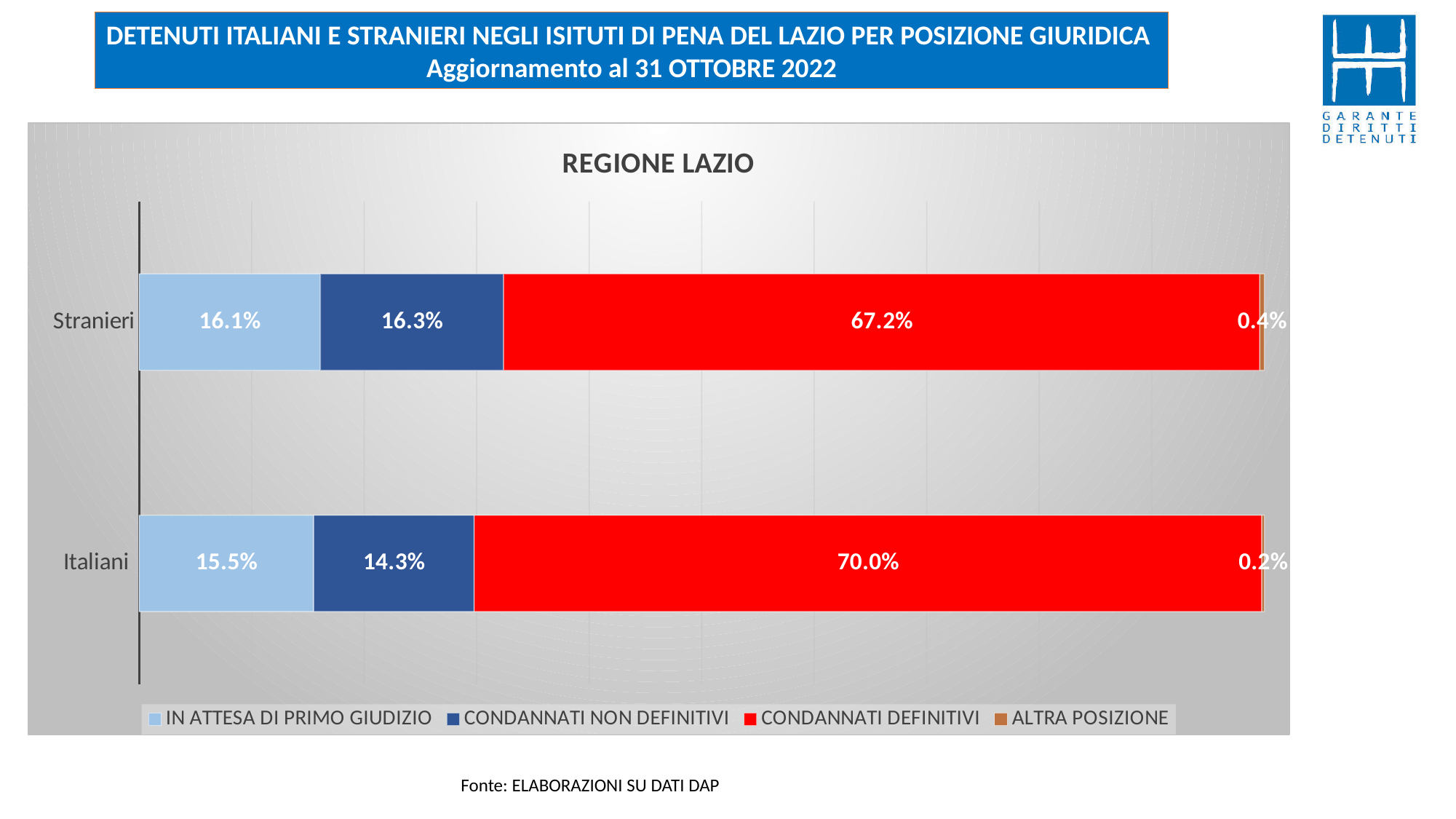
How many categories are shown on the chart? 2 What is the value for IN ATTESA DI PRIMO GIUDIZIO for Stranieri? 16.1% Which series has the largest value in the Stranieri bar? CONDANNATI DEFINITIVI Which series has the smallest value in the Italiani bar? ALTRA POSIZIONE How many series does the legend list? 4 What kind of chart is shown on the slide? Stacked bar chart What is the value for ALTRA POSIZIONE for Stranieri? 0.4% What is the value for CONDANNATI NON DEFINITIVI for Italiani? 14.3% What is the difference between the CONDANNATI NON DEFINITIVI values for Stranieri and Italiani? 2.0% What is the value for CONDANNATI DEFINITIVI for Italiani? 70.0% What is the difference between the CONDANNATI DEFINITIVI values for Italiani and Stranieri? 2.8% Which category has the higher value for CONDANNATI DEFINITIVI, Stranieri or Italiani? Italiani